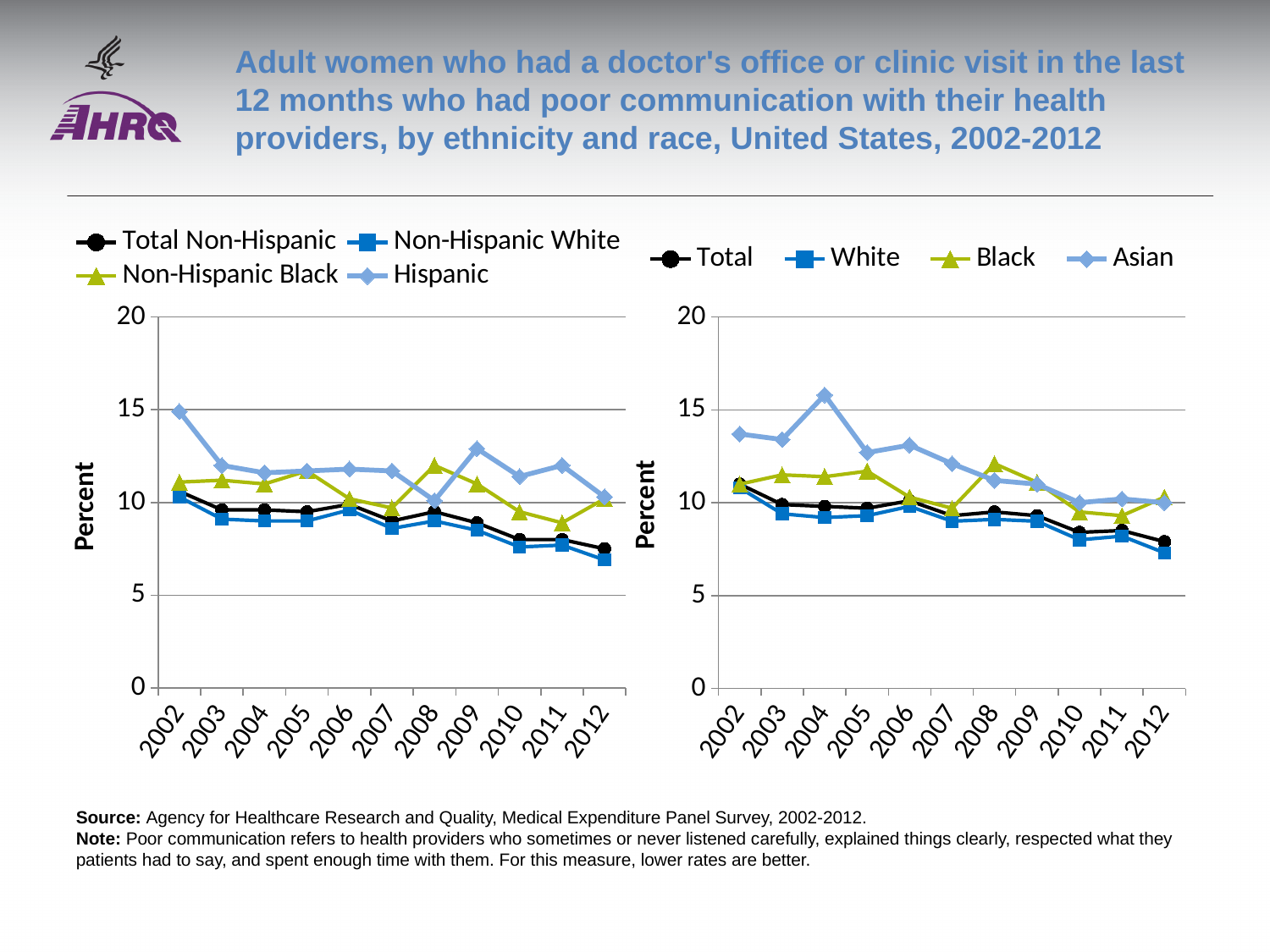
What is the label on the y axis of the right chart? Percent In the left chart, is the value for Hispanic in 2002 greater or less than 10? greater In the left chart, which series has the highest value in 2002? Hispanic In the right chart, is the value for Asian in 2004 greater or less than 15? greater In the left chart, does the Non-Hispanic White series rise or fall from 2002 to 2012? fall In the right chart, which series has the highest value in 2004? Asian In the right chart, which is larger in 2002, Asian or White? Asian How many series does the legend of the right chart list? 4 How many series does the legend of the left chart list? 4 What kind of chart is the left chart (by ethnicity)? line chart How many years are plotted along the x axis of the left chart? 11 In the left chart, is the value for Non-Hispanic White in 2012 greater or less than 10? less